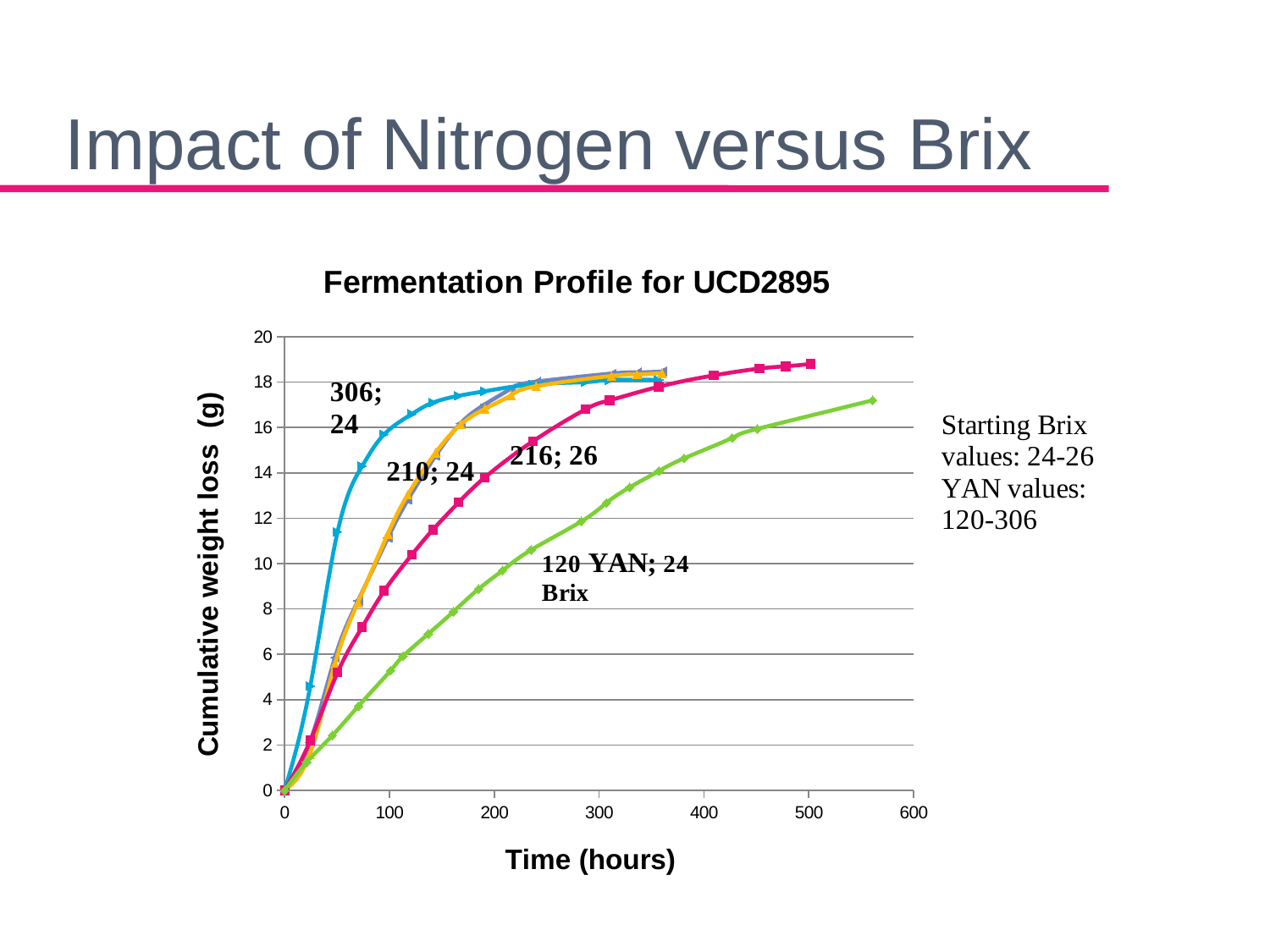
Which line rises fastest in the first 100 hours? 306; 24 Which line has the lowest cumulative weight loss at 200 hours? 120 YAN; 24 Brix Do the values of the 120 YAN; 24 Brix line rise or fall as time increases? rise Is the value for the 120 YAN; 24 Brix line at 300 hours greater or less than 14? less What is the highest value shown on the y axis of the chart? 20 What kind of chart is shown on the slide? line chart Is the value for the 216; 26 line at 500 hours greater or less than 18? greater Is the value for the 306; 24 line at 100 hours greater or less than 14? greater What is the title of the chart? Fermentation Profile for UCD2895 What is the label of the y axis of the chart? Cumulative weight loss (g) Which line reaches the highest cumulative weight loss by the end of its run, 216; 26 or 120 YAN; 24 Brix? 216; 26 Which line extends furthest along the time axis? 120 YAN; 24 Brix